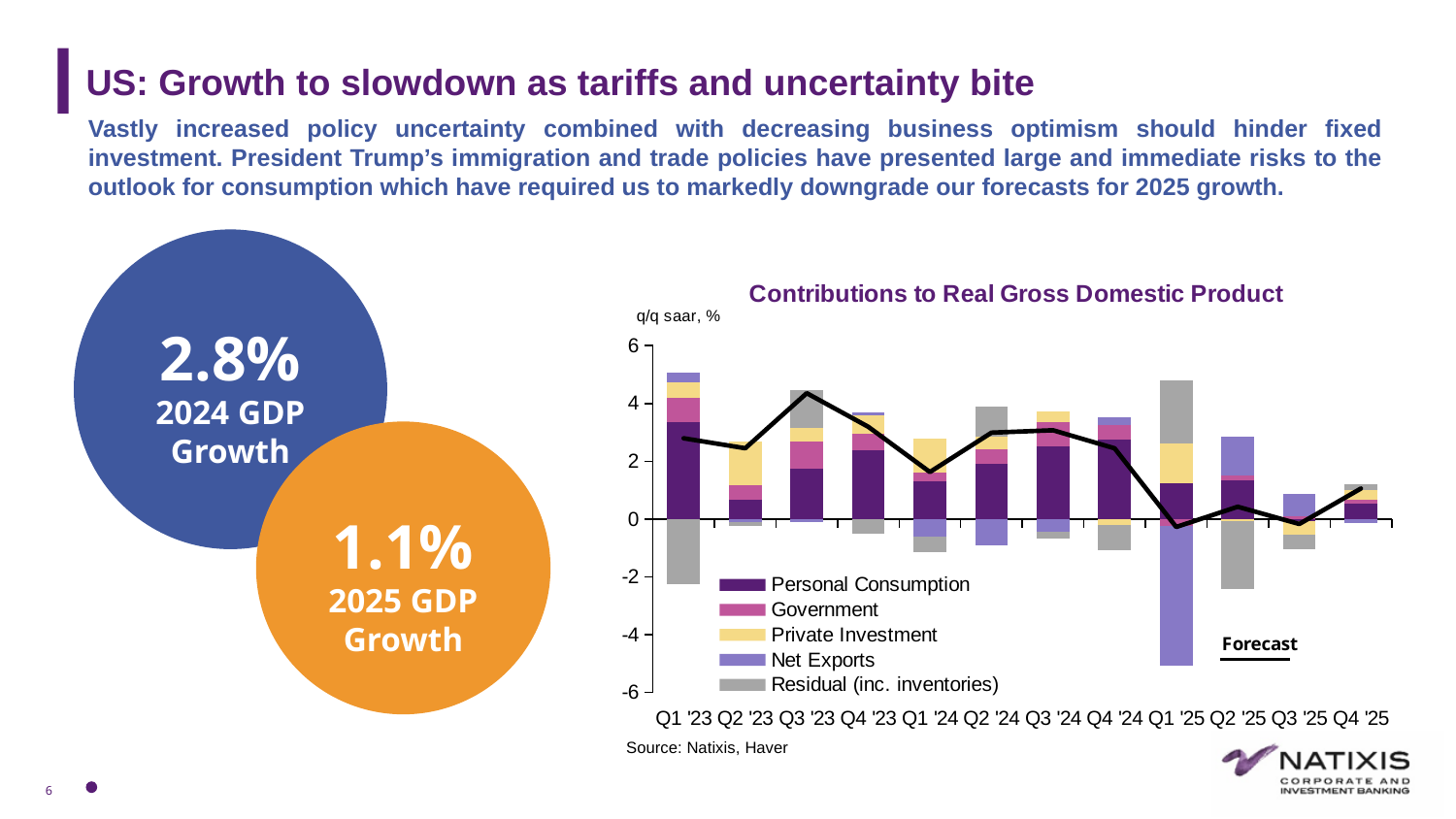
Is the black line value in Q1 '24 greater or less than 2? less Is the black line value in Q1 '25 greater or less than 0? less How many quarters are shown along the x axis of the chart? 12 Is the black line value in Q4 '25 greater or less than 0? greater What kind of chart is shown under the title "Contributions to Real Gross Domestic Product"? Stacked bar chart with a line What unit label is shown above the y axis of the chart? q/q saar, % What is the title of the chart? Contributions to Real Gross Domestic Product Which quarter has the highest value of the black line? Q3 '23 How many series does the chart's legend list? 5